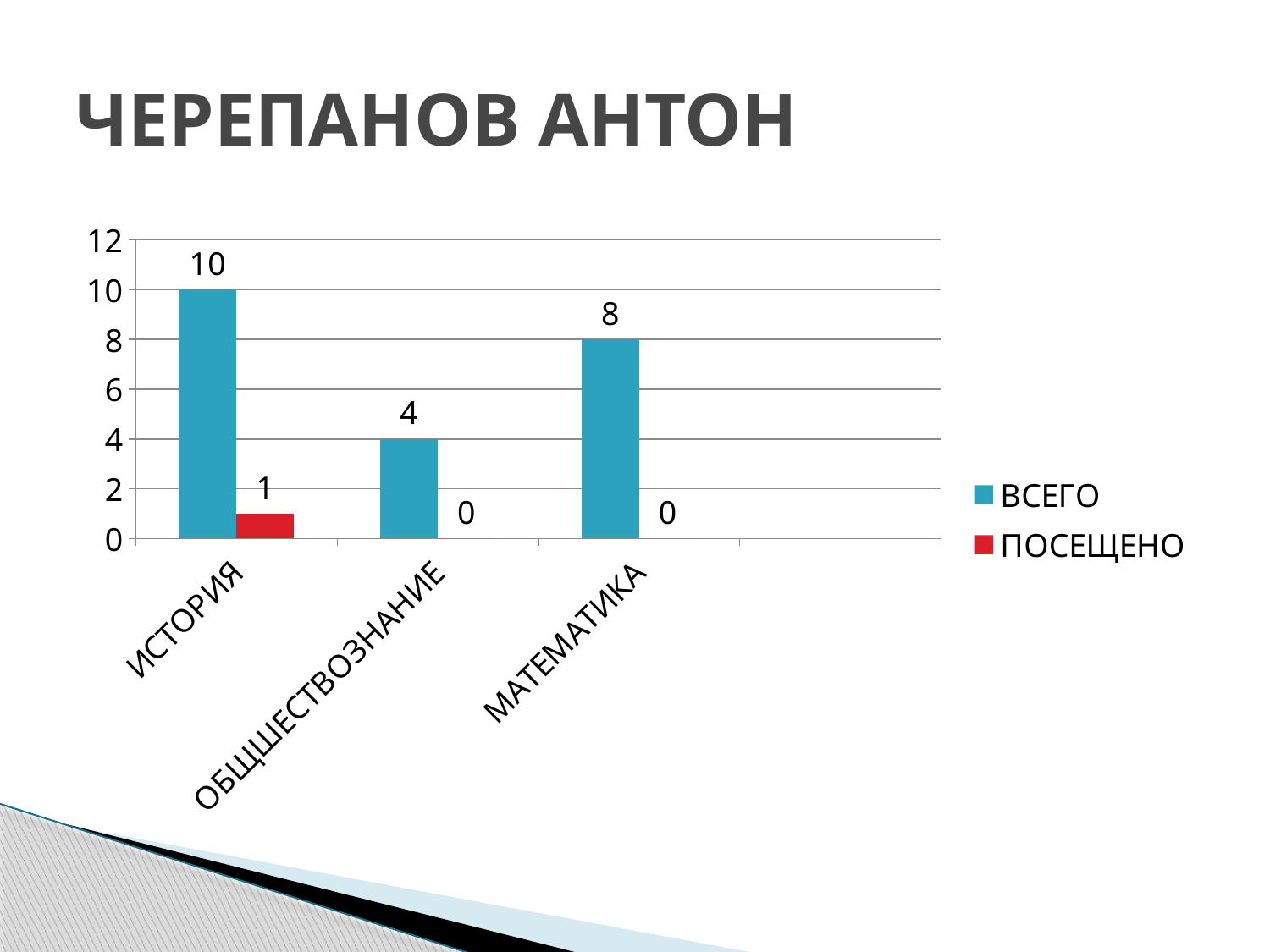
What kind of chart is shown on the slide? Bar chart Which is larger: the ВСЕГО value for ОБЩЕСТВОЗНАНИЕ or for МАТЕМАТИКА? МАТЕМАТИКА Which category has the highest ВСЕГО value? ИСТОРИЯ What is the difference between the ВСЕГО values for ИСТОРИЯ and МАТЕМАТИКА? 2 What is the ПОСЕЩЕНО value for ИСТОРИЯ? 1 What is the ВСЕГО value for ИСТОРИЯ? 10 What is the ВСЕГО value for ОБЩЕСТВОЗНАНИЕ? 4 Which category has the lowest ВСЕГО value? ОБЩЕСТВОЗНАНИЕ How many series does the legend list? 2 What is the ПОСЕЩЕНО value for МАТЕМАТИКА? 0 How many categories are shown on the x axis? 3 What is the ВСЕГО value for МАТЕМАТИКА? 8